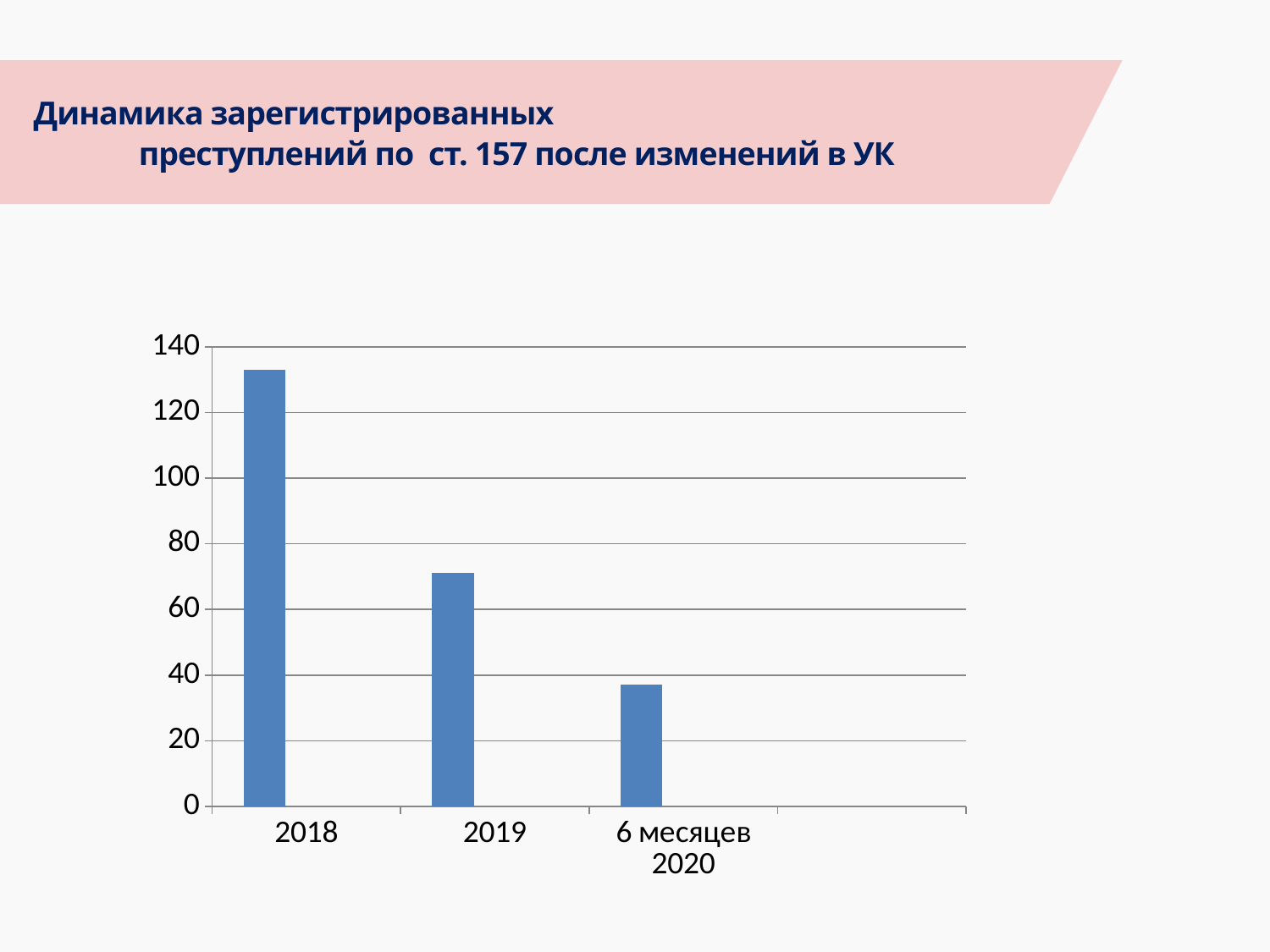
Is the value for 6 месяцев 2020 greater or less than 20? greater Is the value for 2018 greater or less than 120? greater Is the value for 2019 greater or less than 60? greater How many categories are shown on the x axis of the chart? 3 What is the maximum value shown on the vertical axis of the chart? 140 Which category has the highest bar in the chart? 2018 Do the values rise or fall from 2018 to 6 месяцев 2020? fall What kind of chart is shown on the slide? bar chart Which category has the lowest bar in the chart? 6 месяцев 2020 Which is larger, the value for 2018 or the value for 2019? 2018